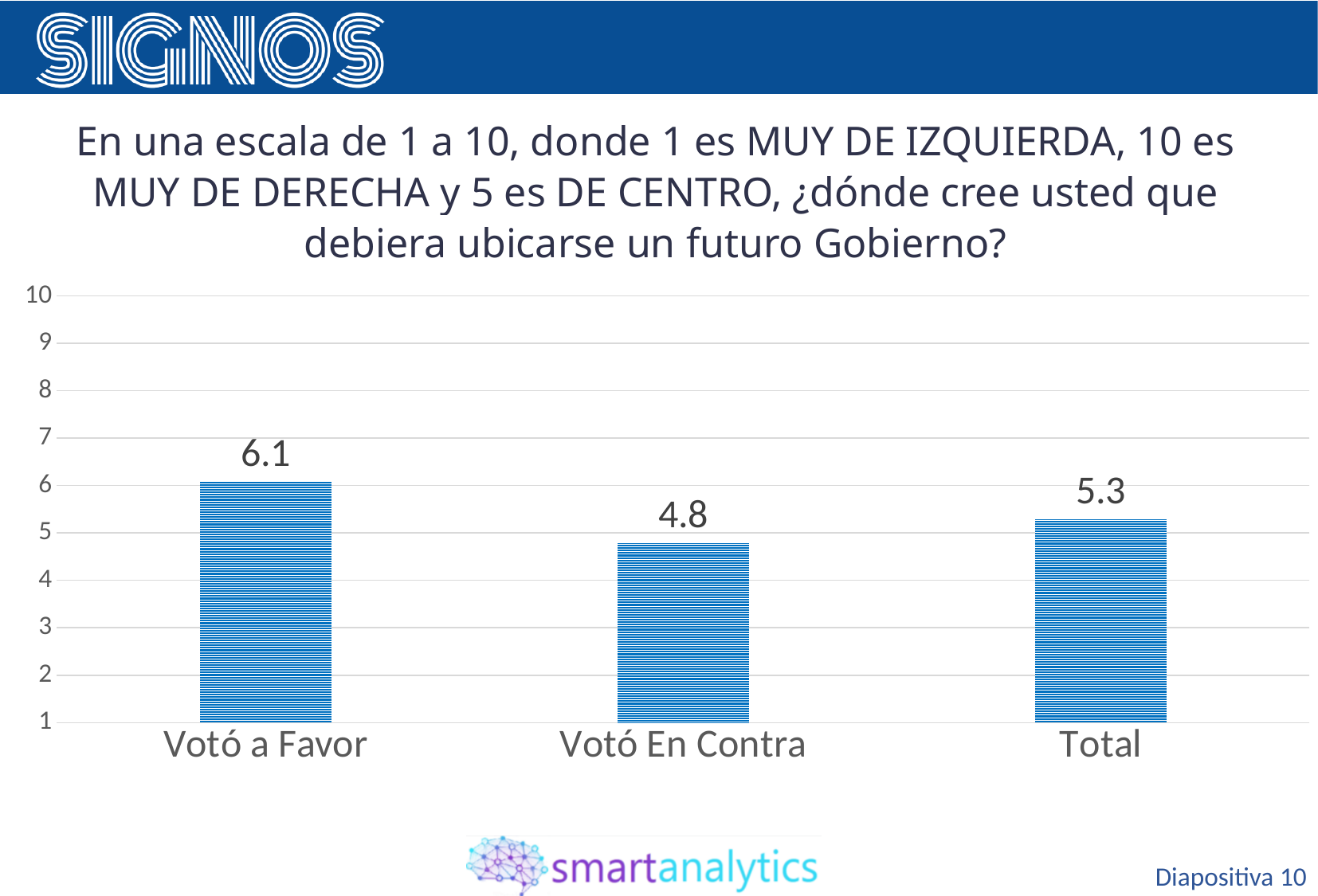
What is the difference between the values for Votó a Favor and Total? 0.8 What is the value for Total? 5.3 Which category has the highest value? Votó a Favor What is the difference between the values for Votó a Favor and Votó En Contra? 1.3 How many categories are shown on the x axis? 3 Is the value for Votó En Contra greater or less than 5? less Is the value for Votó a Favor greater or less than 6? greater What is the value for Votó En Contra? 4.8 What is the value for Votó a Favor? 6.1 What kind of chart is shown on the slide? bar chart Which is larger, the value for Votó En Contra or the value for Total? Total Which category has the lowest value? Votó En Contra